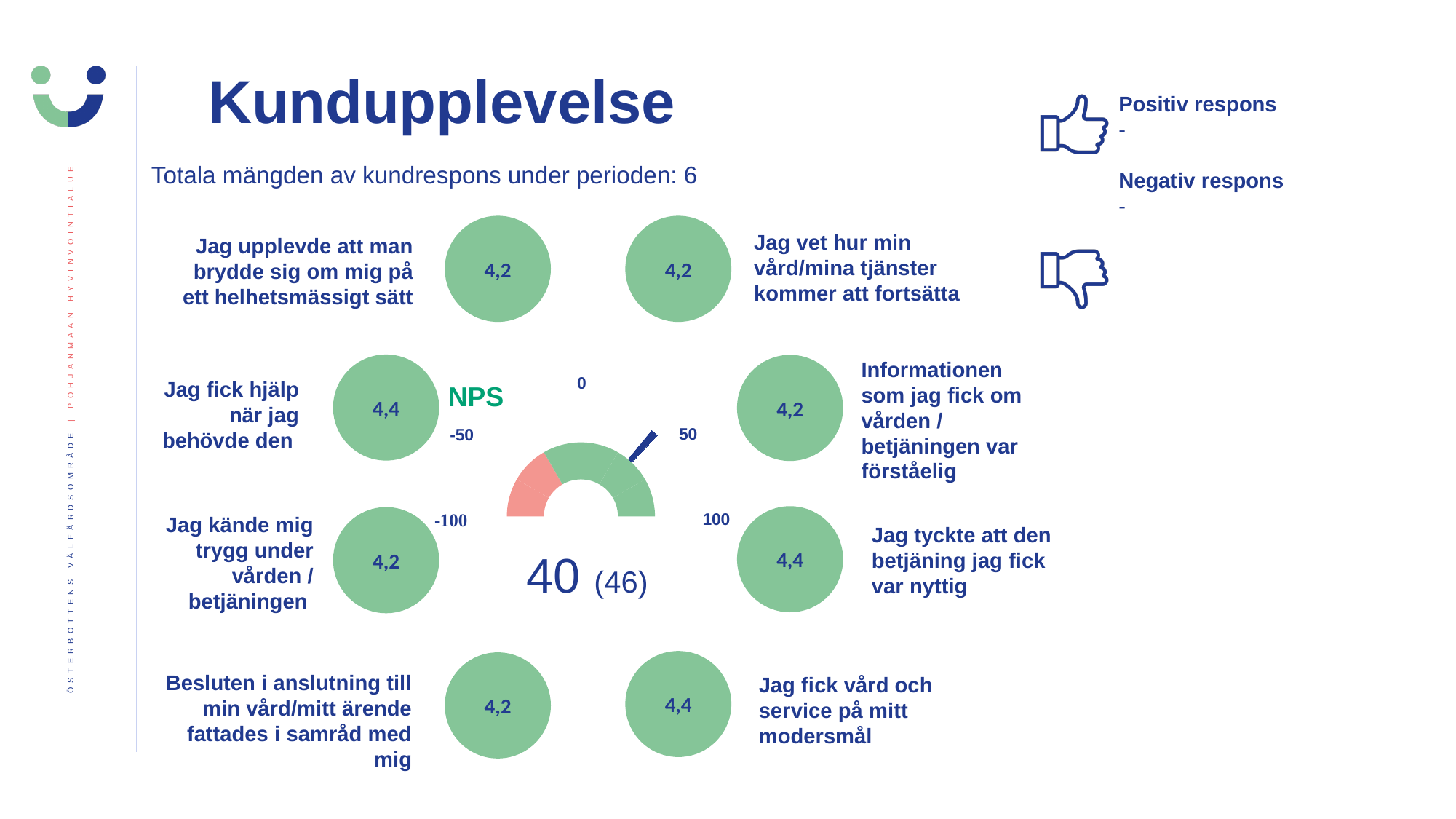
What score is shown in the circle for "Jag fick hjälp när jag behövde den"? 4,4 What NPS value does the gauge chart show? 40 What is the highest value marked on the NPS gauge scale? 100 What label is printed in green next to the gauge chart? NPS What colour is the negative (left) segment of the NPS gauge? red What score is shown in the circle for "Jag kände mig trygg under vården / betjäningen"? 4,2 What is the lowest value marked on the NPS gauge scale? -100 How many tick labels are printed on the NPS gauge scale? 5 What kind of chart is used to display the NPS? gauge chart Is the NPS value on the gauge greater or less than 50? less Is the NPS value on the gauge greater or less than 0? greater What value is shown in parentheses next to the NPS value of 40? (46)